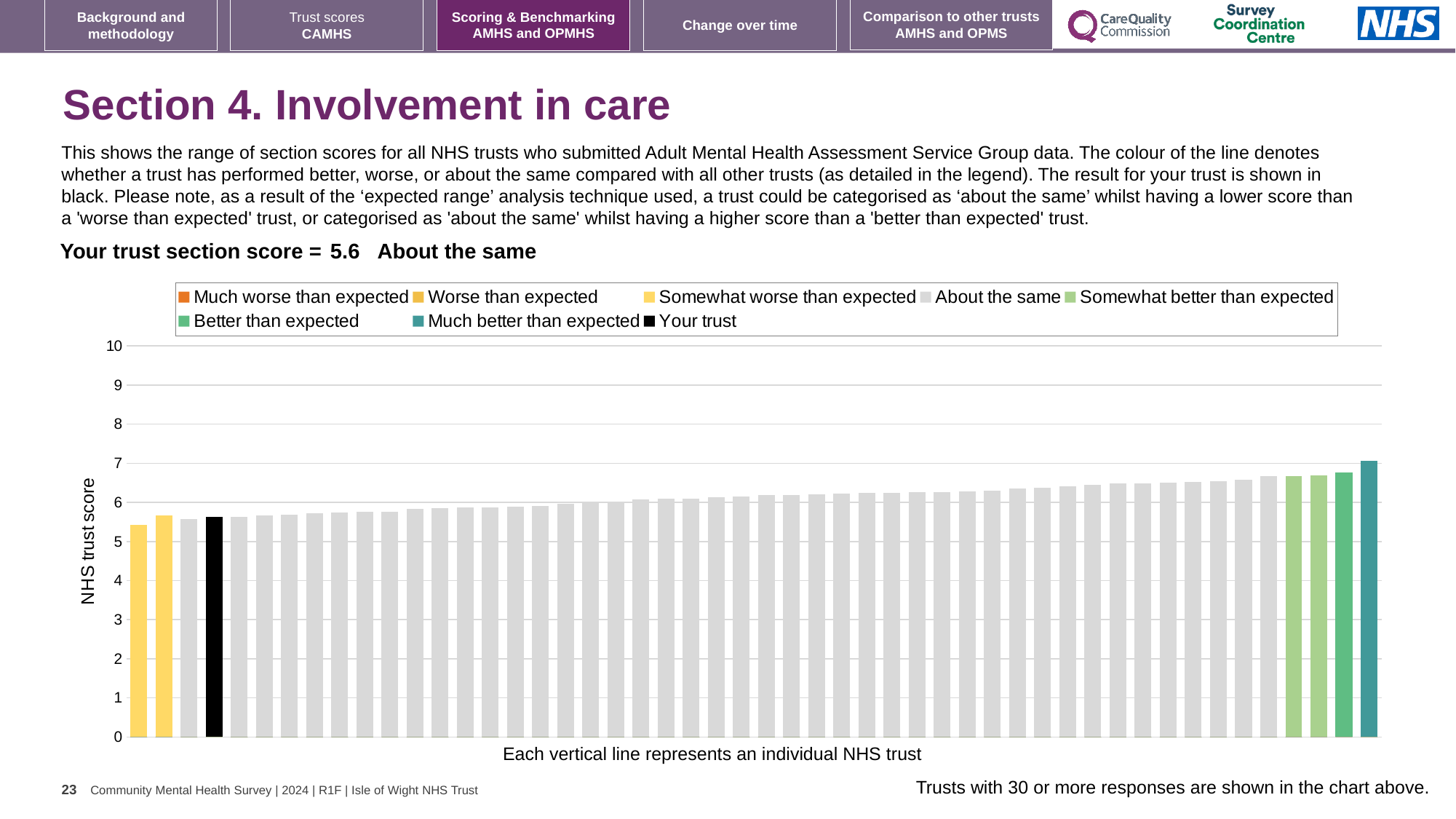
How many bars are coloured as 'Worse than expected'? 0 What is the label on the vertical axis of the chart? NHS trust score Is the value for your trust (the black bar) greater or less than 5? greater How many bars are coloured as 'Much better than expected'? 1 Which legend category does the shortest bar in the chart belong to? Somewhat worse than expected Is the value of the tallest bar in the chart greater or less than 6? greater Is the value of the shortest bar in the chart greater or less than 6? less What type of chart is shown on the slide? bar chart Do the bar values rise or fall from left to right across the chart? rise What is the section score for your trust shown on the slide? 5.6 Which legend category does the tallest bar in the chart belong to? Much better than expected How many entries does the chart legend list? 8